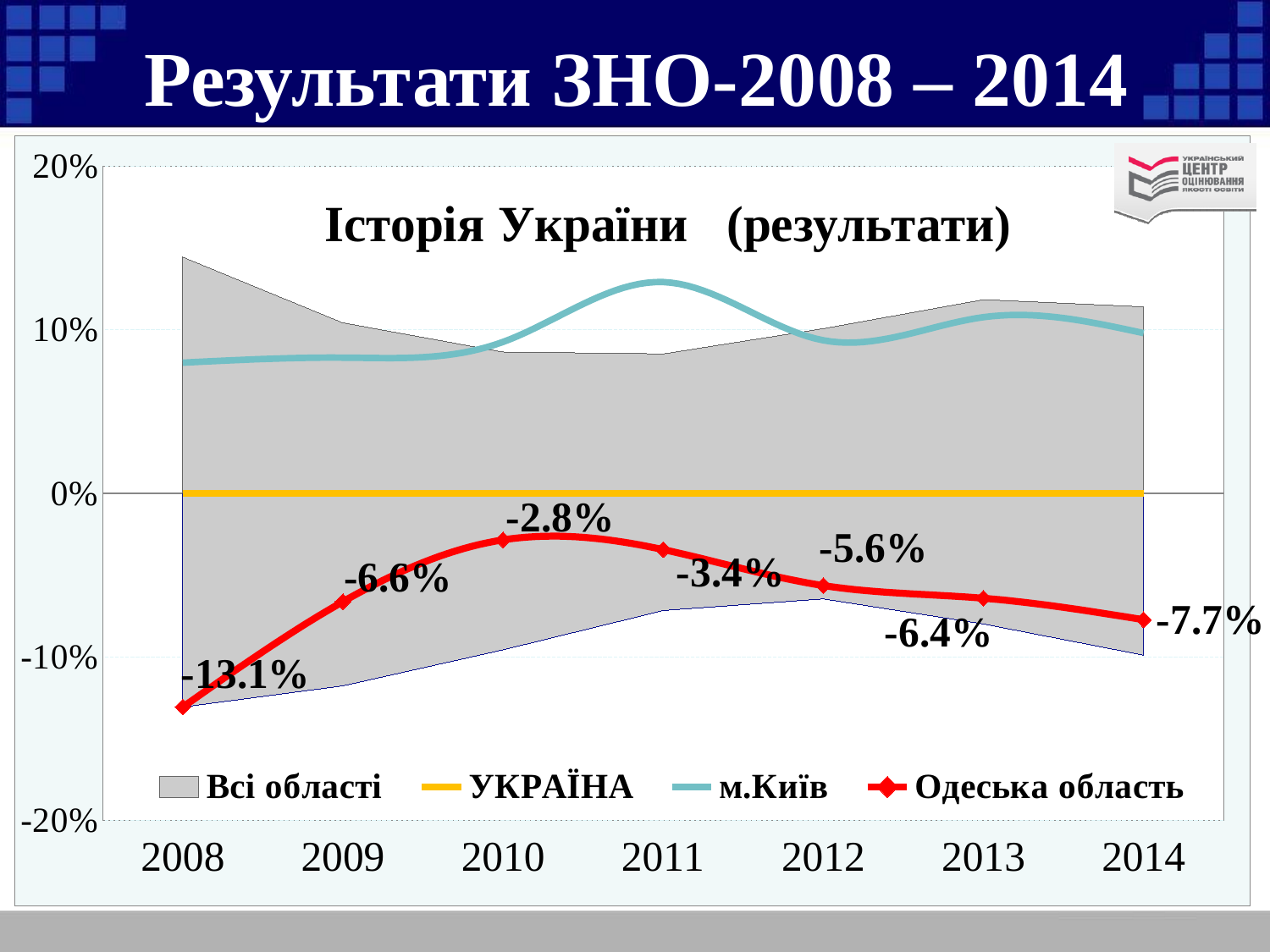
What is the title of the chart? Історія України (результати) In which year does Одеська область reach its highest value? 2010 What is the value for Одеська область in 2008? -13.1% What is the value for Одеська область in 2014? -7.7% Does the Одеська область line rise or fall from 2010 to 2014? fall What is the value for Одеська область in 2010? -2.8% In which year does Одеська область have its lowest value? 2008 What is the difference between the Одеська область values in 2009 and 2008? 6.5 percentage points Which is larger for Одеська область: the value in 2011 or the value in 2012? 2011 How many series does the legend list? 4 How many years are shown on the x axis? 7 Is the value for м.Київ in 2011 greater or less than 10%? greater